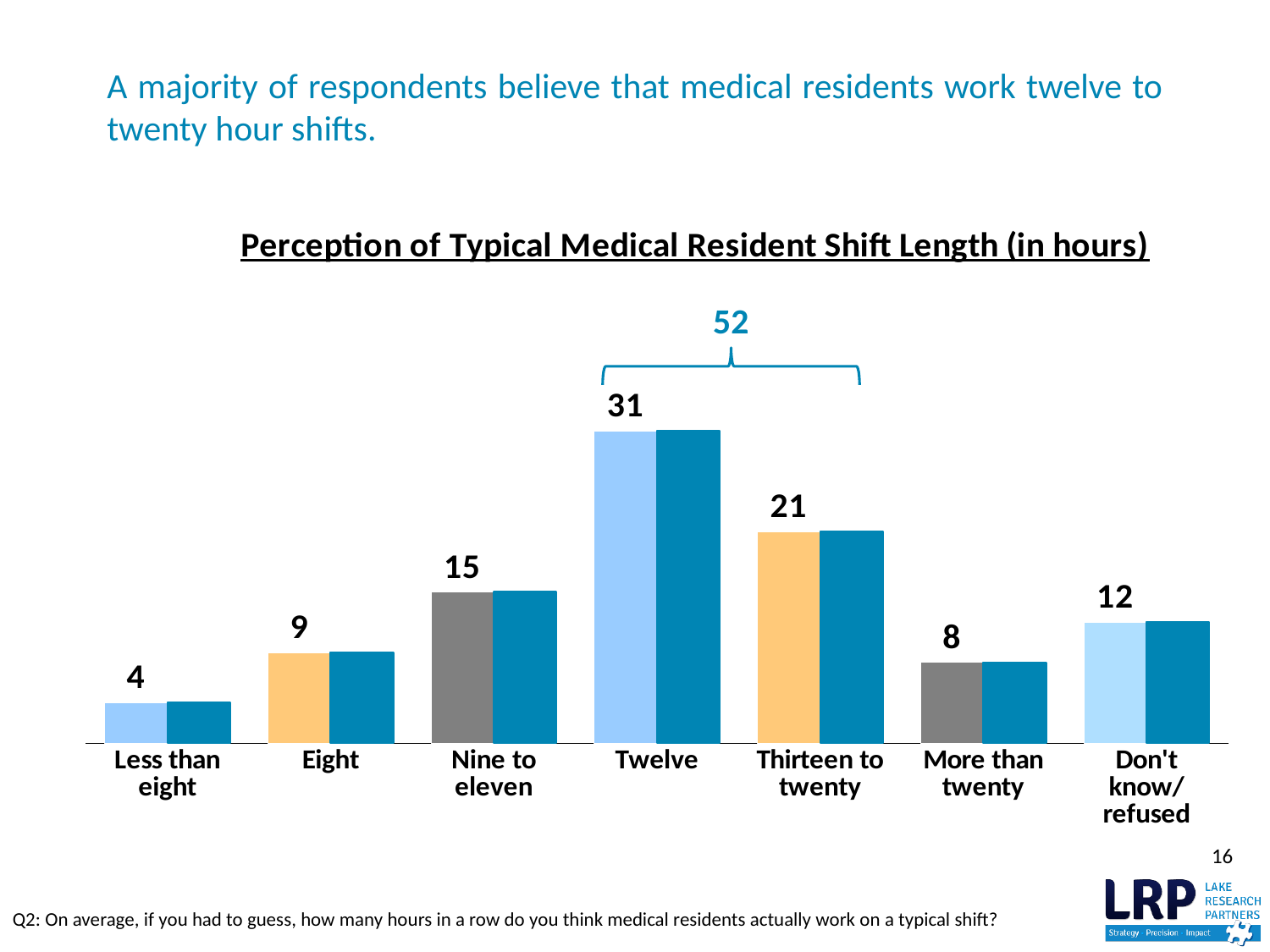
Which is larger, the value for "Nine to eleven" or the value for "Don't know/refused"? Nine to eleven What value is shown for the "Less than eight" category? 4 What value is shown for the "Twelve" category? 31 What combined value does the bracket above the "Twelve" and "Thirteen to twenty" bars show? 52 What is the difference between the values for "Twelve" and "Thirteen to twenty"? 10 What value is shown for the "Thirteen to twenty" category? 21 How many categories are shown on the x axis? 7 Which category has the highest value? Twelve What kind of chart is shown on the slide? Bar chart What value is shown for the "Don't know/refused" category? 12 What is the title of the chart? Perception of Typical Medical Resident Shift Length (in hours) Which category has the lowest value? Less than eight